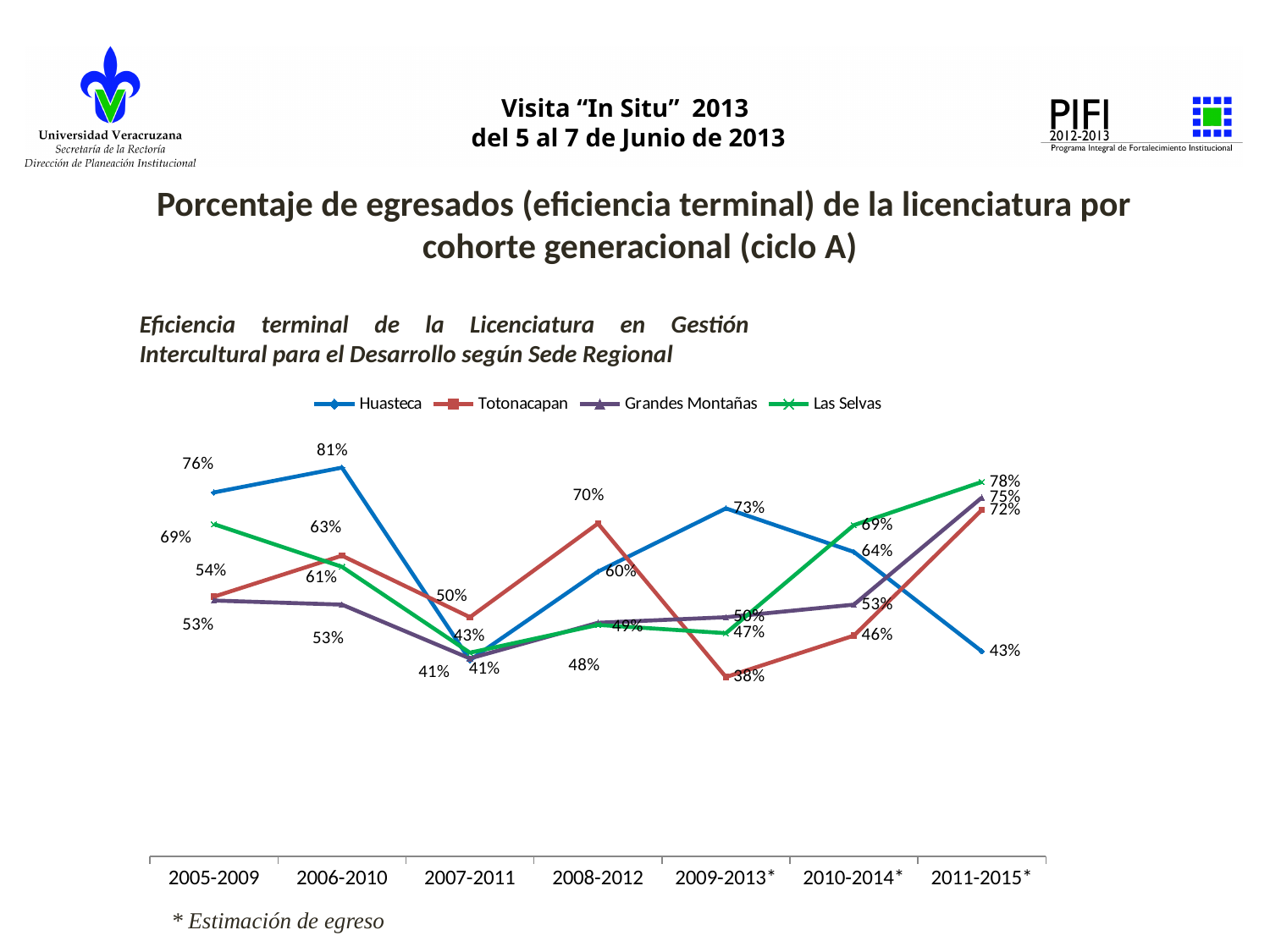
What is the value for Huasteca in the 2011-2015* cohort? 43% What is the value for Totonacapan in the 2009-2013* cohort? 38% What is the value for Las Selvas in the 2011-2015* cohort? 78% What is the value for Huasteca in the 2006-2010 cohort? 81% In the 2011-2015* cohort, which is higher: Las Selvas or Huasteca? Las Selvas How many series does the legend list? 4 What kind of chart is shown on the slide? line chart What is the difference between Huasteca's value in 2006-2010 and its value in 2011-2015*? 38 percentage points In which cohort does Huasteca reach its highest value? 2006-2010 Does the Huasteca line rise or fall from 2009-2013* to 2011-2015*? fall In which cohort does Totonacapan have its lowest value? 2009-2013* How many generational cohorts are shown on the x axis? 7